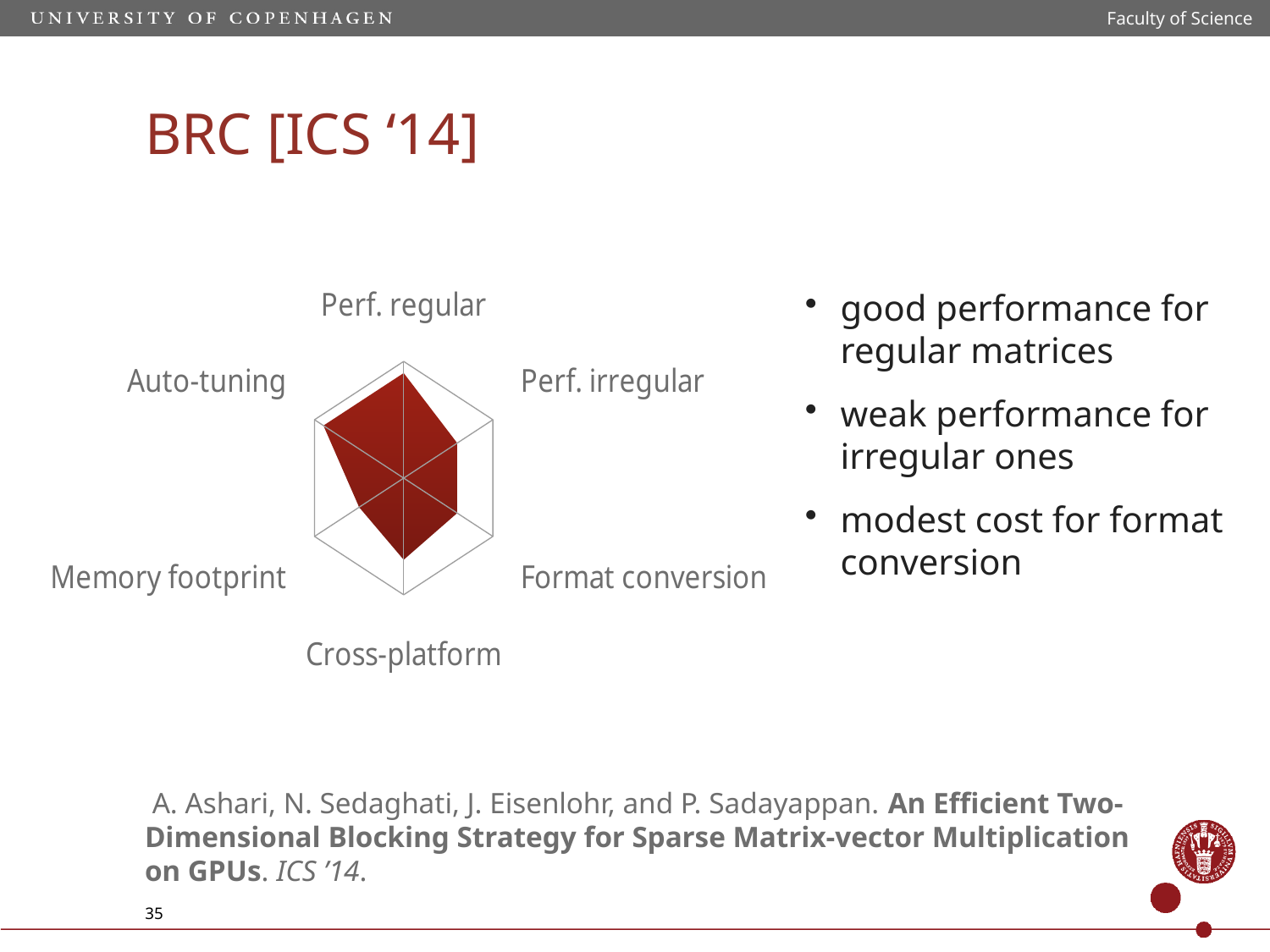
Which is larger on the radar chart, the value for Cross-platform or the value for Memory footprint? Cross-platform What colour is the filled area of the radar chart? dark red Which is larger on the radar chart, the value for Perf. regular or the value for Perf. irregular? Perf. regular Which is larger on the radar chart, the value for Auto-tuning or the value for Memory footprint? Auto-tuning Which category label appears at the top of the radar chart? Perf. regular What kind of chart is shown on the slide? radar chart How many categories (axes) does the radar chart have? 6